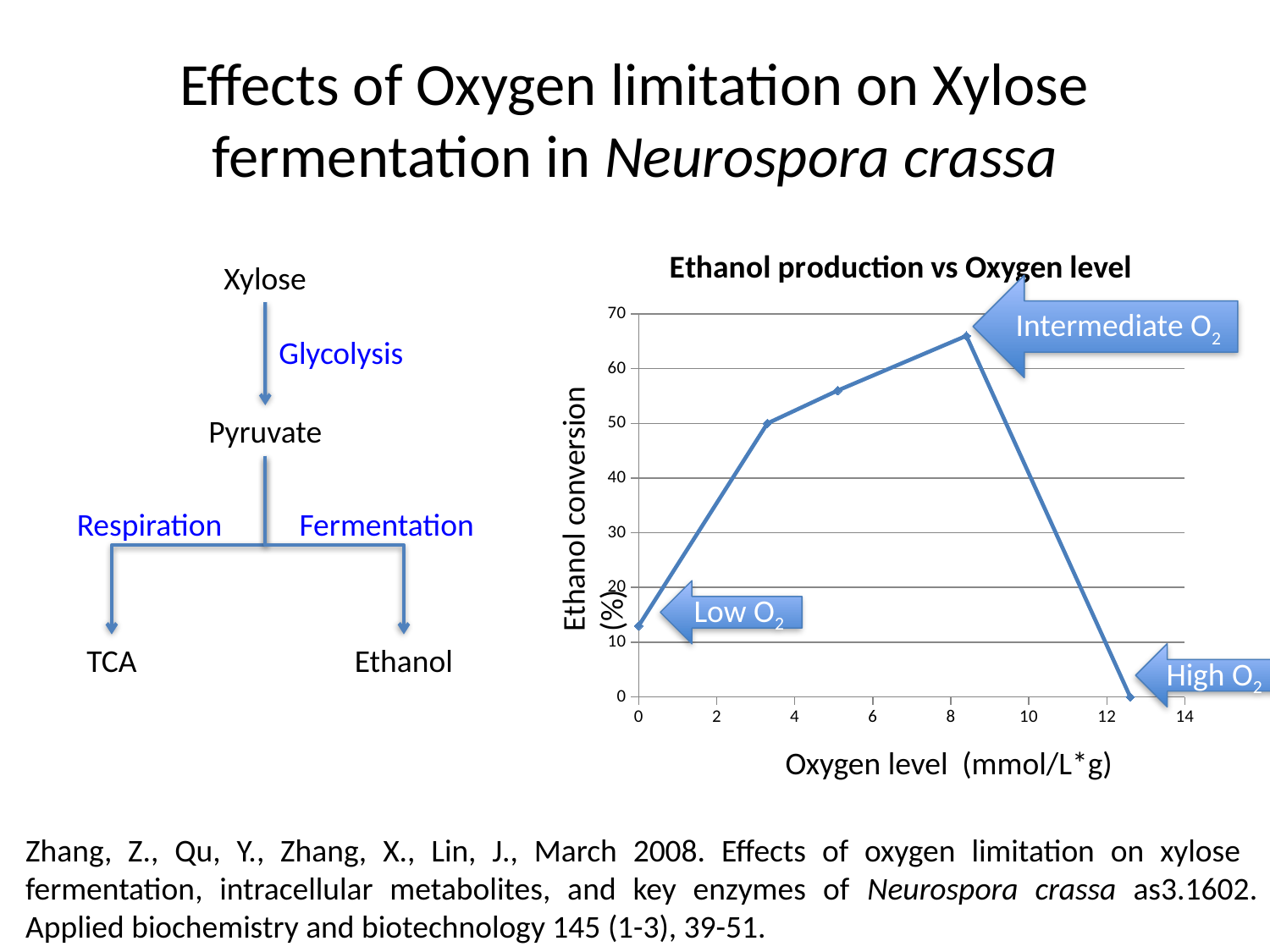
How many data points are plotted on the line? 5 What is the title of the chart? Ethanol production vs Oxygen level Does ethanol conversion rise or fall as oxygen level increases from 0 to 8? rise Is the ethanol conversion at the Intermediate O2 point greater or less than 60? greater Which has the higher ethanol conversion, the Low O2 point or the Intermediate O2 point? Intermediate O2 Is the ethanol conversion at the High O2 point greater or less than 10? less At which annotated oxygen level (Low O2, Intermediate O2 or High O2) is ethanol conversion lowest? High O2 At which annotated oxygen level (Low O2, Intermediate O2 or High O2) is ethanol conversion highest? Intermediate O2 What is the label of the x axis of the chart? Oxygen level (mmol/L*g) Is the ethanol conversion at the Low O2 point greater or less than 20? less Does ethanol conversion rise or fall as oxygen level increases from the Intermediate O2 point to the High O2 point? fall What kind of chart is shown on the slide? line chart